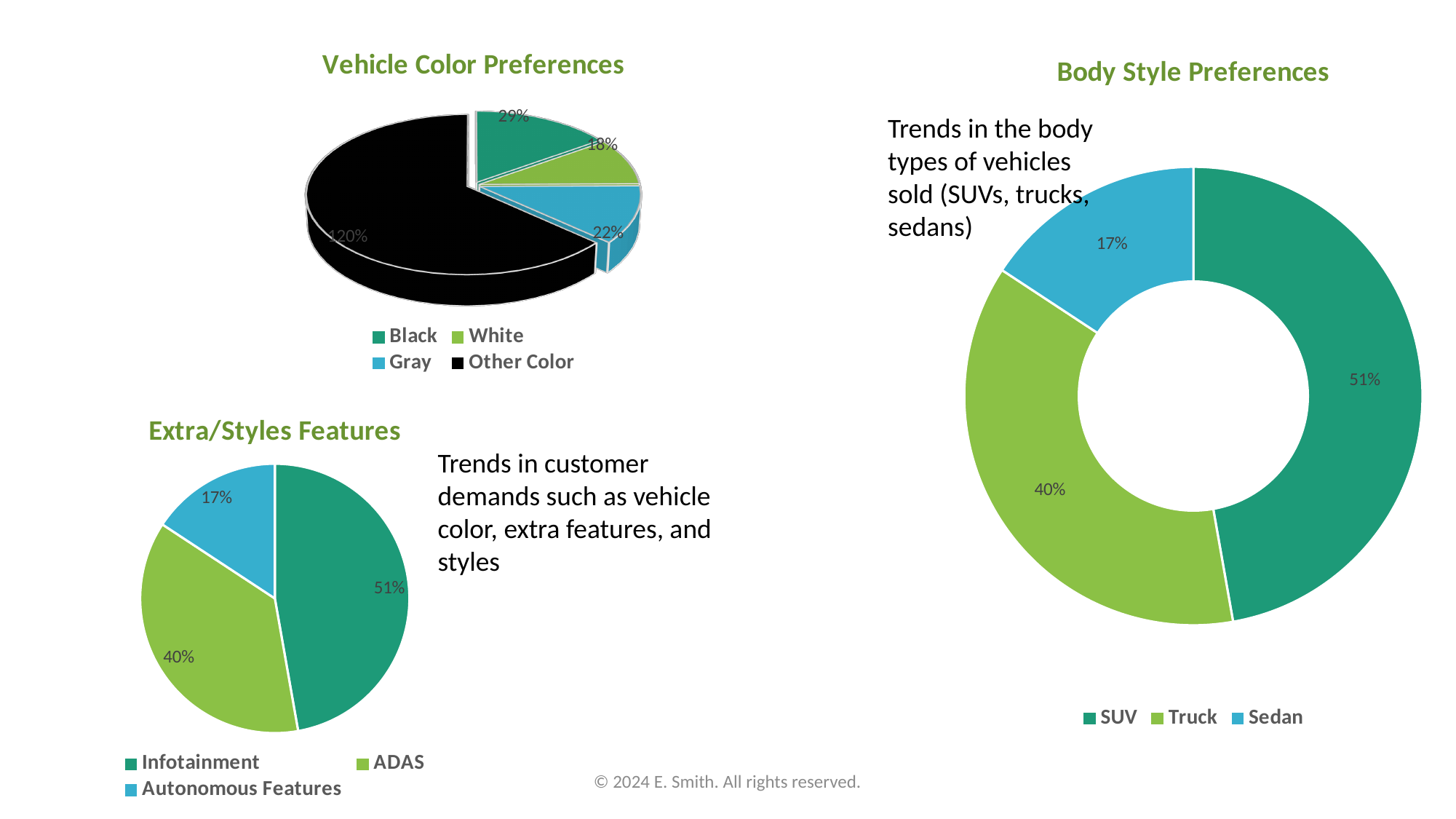
How many categories does the legend of the Vehicle Color Preferences chart list? 4 In the Extra/Styles Features chart, which feature has the largest share? Infotainment In the Extra/Styles Features chart, what percentage is shown for ADAS? 40% In the Vehicle Color Preferences chart, what percentage is shown for White? 18% In the Vehicle Color Preferences chart, which color has the largest slice? Other Color How many categories does the legend of the Body Style Preferences chart list? 3 In the Extra/Styles Features chart, what is the difference between the Infotainment and Autonomous Features percentages? 34% In the Vehicle Color Preferences chart, which color has the smallest slice? White In the Body Style Preferences chart, what percentage is shown for Sedan? 17% In the Body Style Preferences chart, which is larger, Truck or SUV? SUV In the Vehicle Color Preferences chart, what percentage is shown for Gray? 22% What kind of chart is the Body Style Preferences chart? Doughnut chart